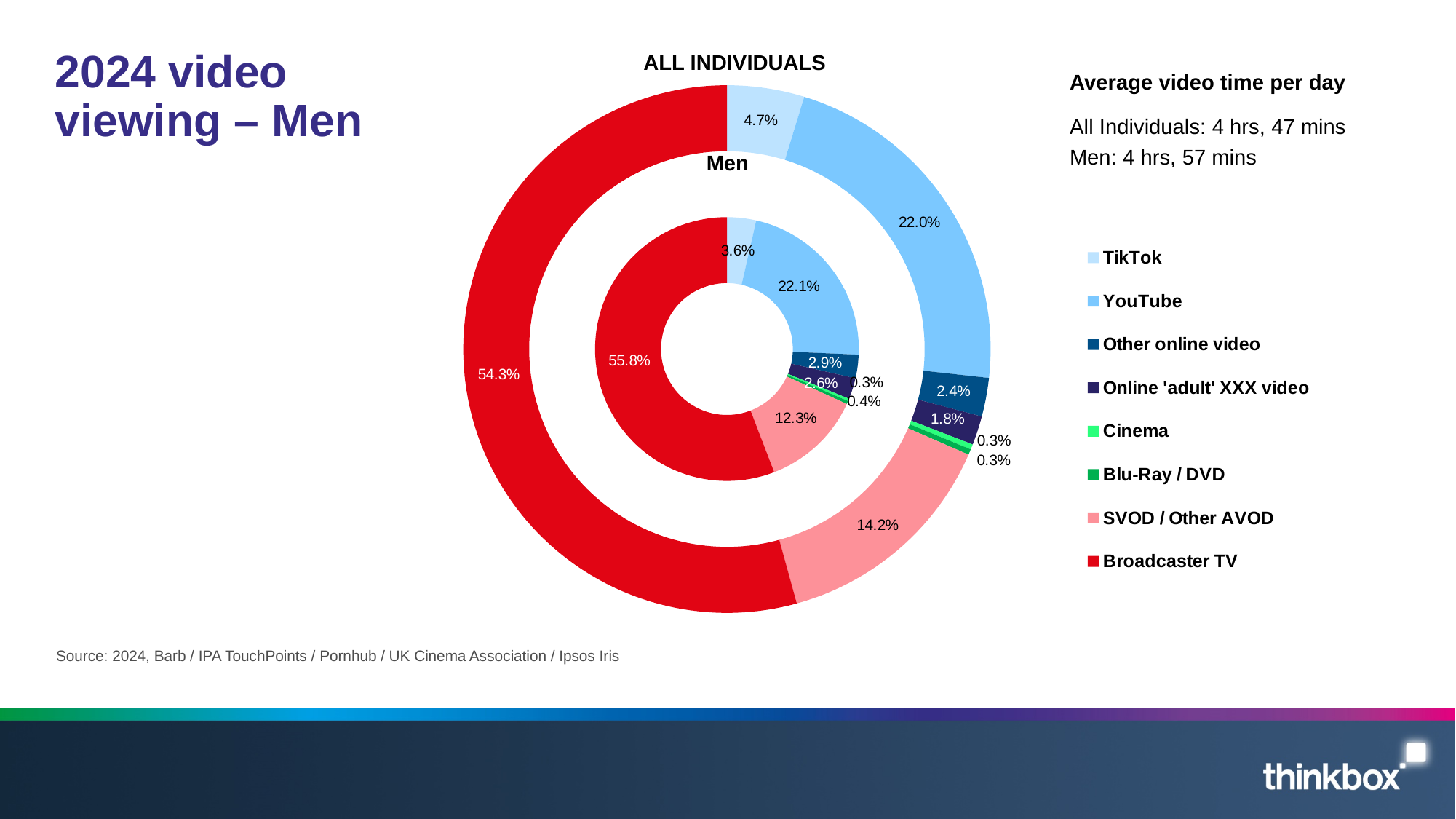
What is the difference between the Broadcaster TV share for Men and for All Individuals? 1.5% What share of video viewing does YouTube account for in the All Individuals ring? 22.0% What is the SVOD / Other AVOD share in the All Individuals ring? 14.2% What is the difference between the SVOD / Other AVOD share for All Individuals and for Men? 1.9% Which category has the largest share in the Men ring? Broadcaster TV Is the TikTok share larger for All Individuals or for Men? All Individuals How many categories does the legend list? 8 According to the text on the slide, what is the average video time per day for Men? 4 hrs, 57 mins What is the TikTok share in the Men ring? 3.6% What share of video viewing does Broadcaster TV account for in the Men ring? 55.8% What kind of chart is shown on the slide? Doughnut chart Which category has the smallest share in the Men ring? Cinema